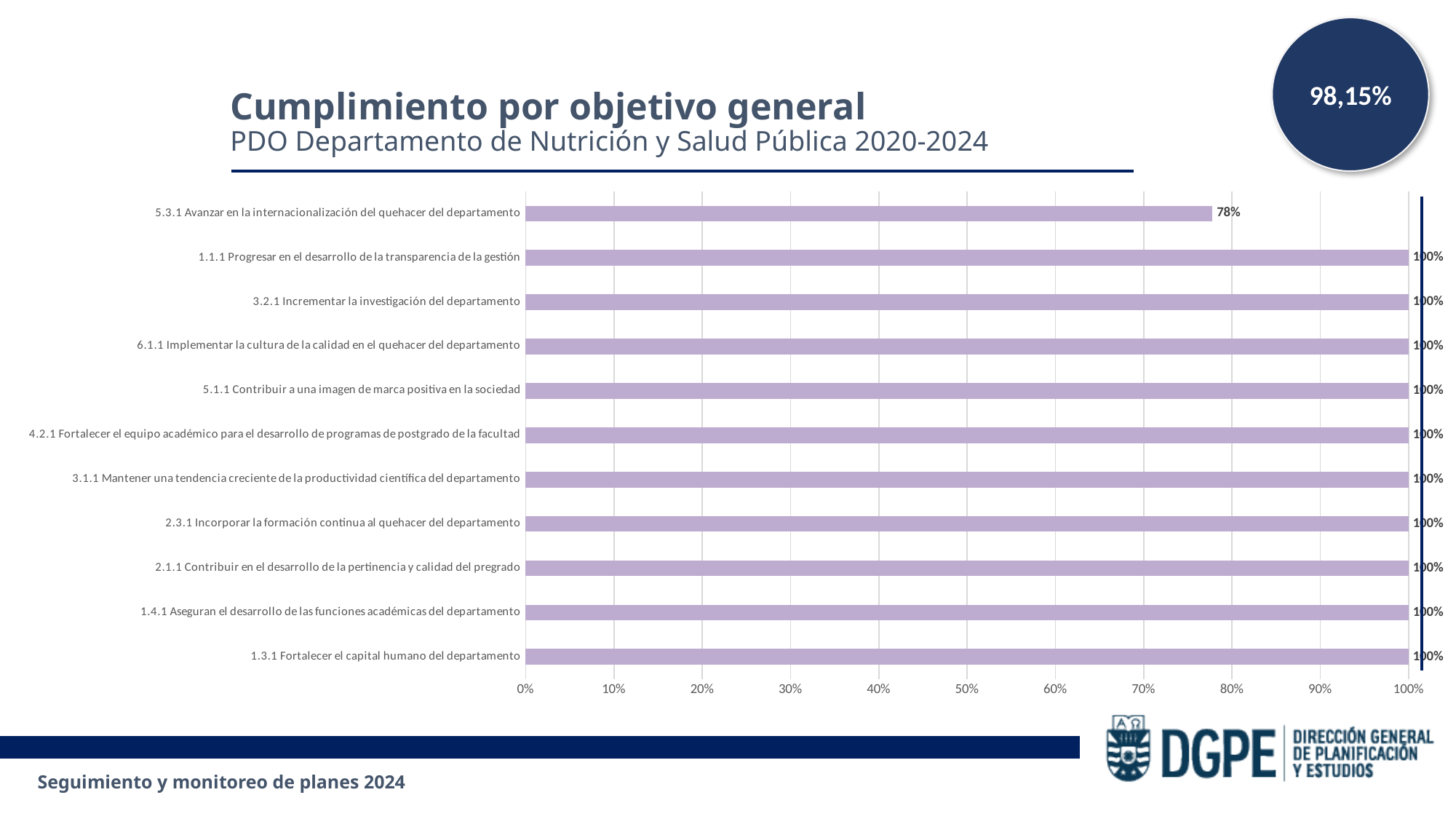
What is the value for "3.2.1 Incrementar la investigación del departamento"? 100% Which is larger: the value for "2.1.1 Contribuir en el desarrollo de la pertinencia y calidad del pregrado" or the value for "5.3.1 Avanzar en la internacionalización del quehacer del departamento"? 2.1.1 Contribuir en el desarrollo de la pertinencia y calidad del pregrado What is the title of the chart? Cumplimiento por objetivo general What is the value for "5.3.1 Avanzar en la internacionalización del quehacer del departamento"? 78% How many objectives are shown in the chart? 11 Which objective has the lowest value in the chart? 5.3.1 Avanzar en la internacionalización del quehacer del departamento Is the value for "5.3.1 Avanzar en la internacionalización del quehacer del departamento" greater or less than 70%? greater What is the value for "1.3.1 Fortalecer el capital humano del departamento"? 100% What is the difference between the value for "1.1.1 Progresar en el desarrollo de la transparencia de la gestión" and the value for "5.3.1 Avanzar en la internacionalización del quehacer del departamento"? 22% What overall percentage is shown in the circle at the top right of the slide? 98,15% How many objectives have a value of 100%? 10 What kind of chart is shown on the slide? bar chart